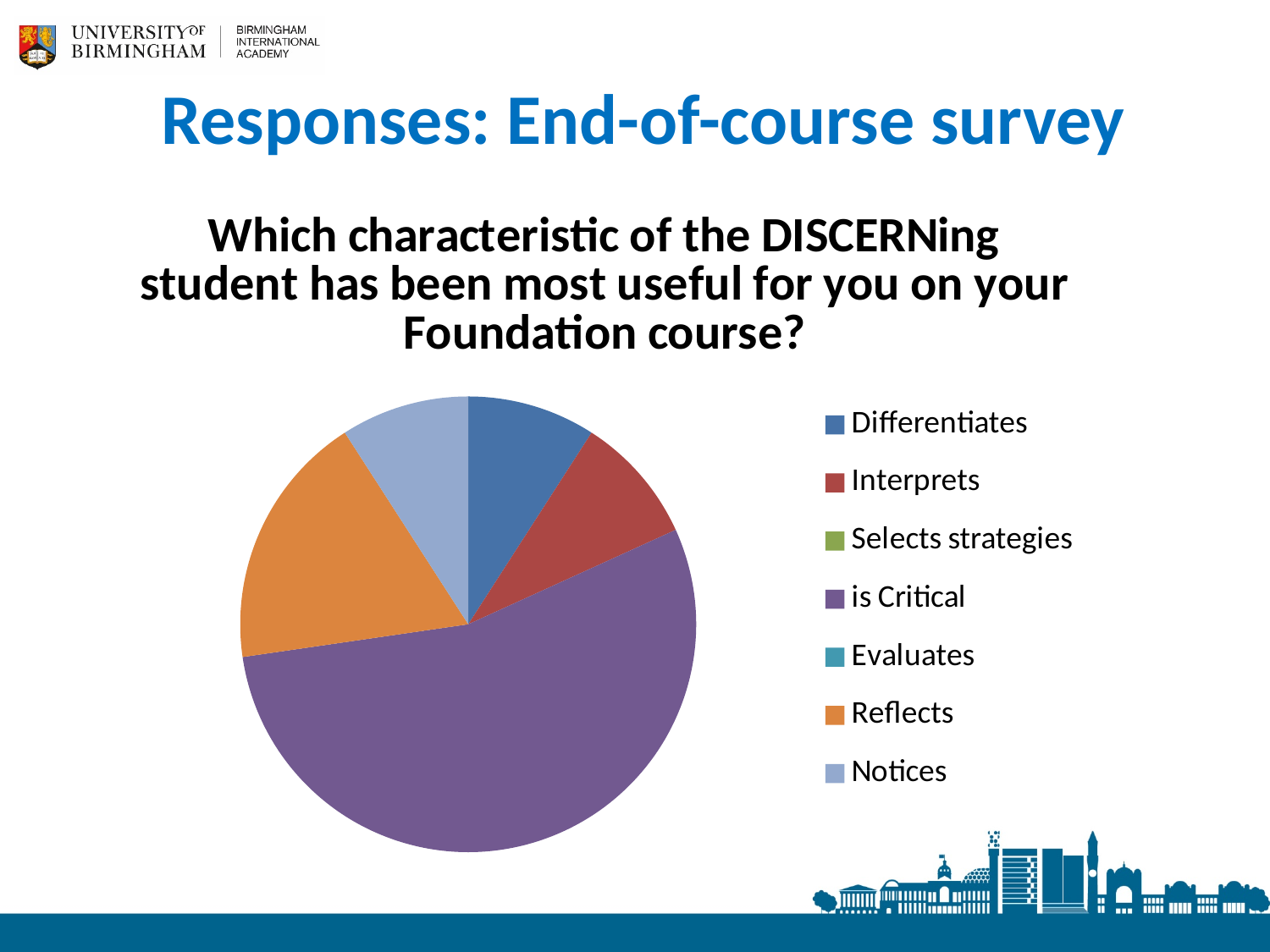
What colour is the is Critical slice? purple What question is the pie chart titled with? Which characteristic of the DISCERNing student has been most useful for you on your Foundation course? Which slice is larger, is Critical or Reflects? is Critical What kind of chart is shown on the slide? pie chart Which slice is larger, Reflects or Interprets? Reflects How many entries does the legend list? 7 Which legend entry is listed first? Differentiates Which slice is larger, is Critical or Differentiates? is Critical Does the is Critical slice take up more or less than half of the pie? more Which characteristic has the largest slice of the pie? is Critical